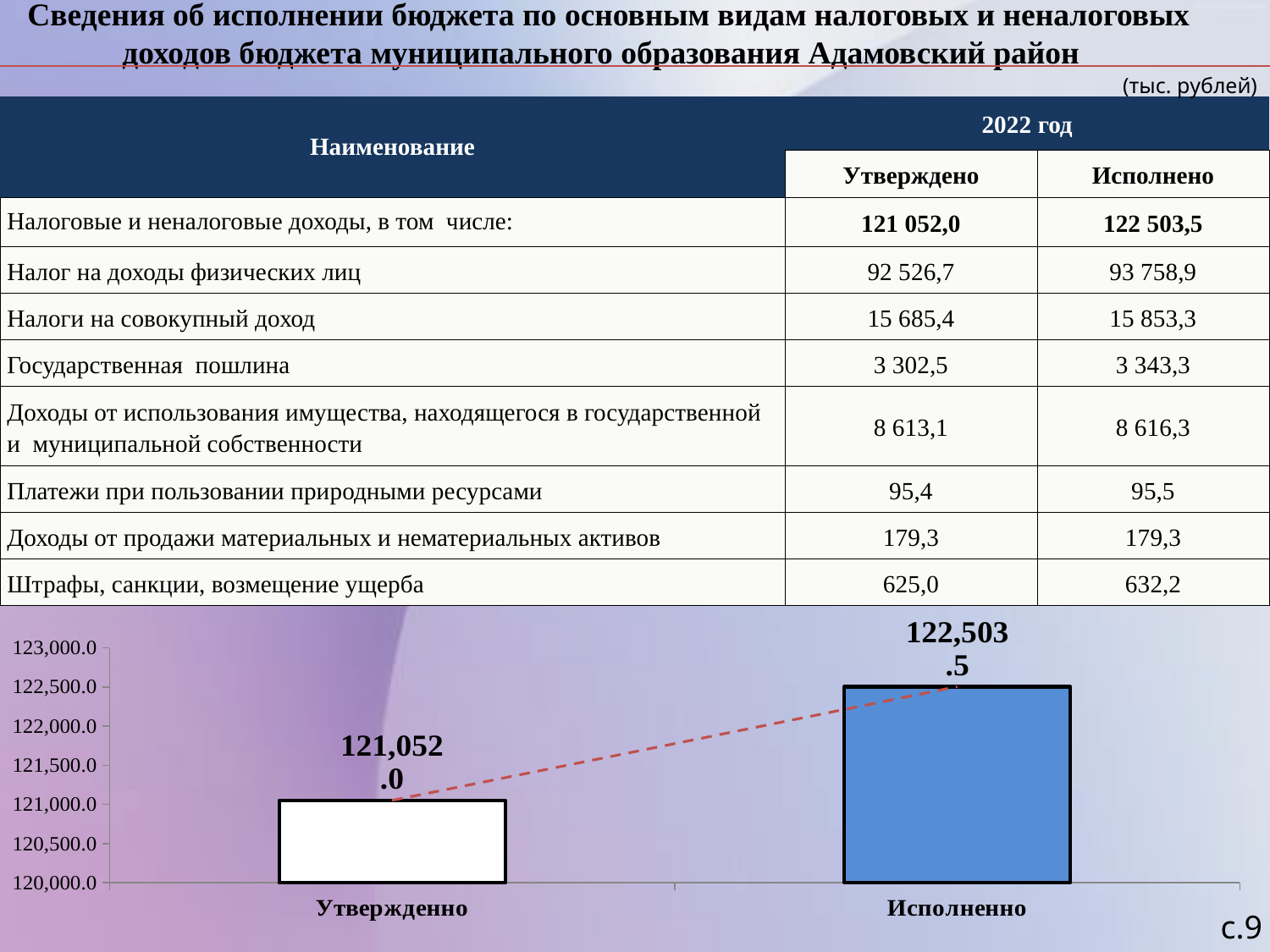
Do the values in the chart rise or fall from Утвержденно to Исполненно? rise Which is larger in the chart, Утвержденно or Исполненно? Исполненно What is the value of the Утвержденно bar in the chart? 121,052.0 What is the value of the Исполненно bar in the chart? 122,503.5 Which bar in the chart is the lowest? Утвержденно What is the difference between the Исполненно and Утвержденно values in the chart? 1,451.5 What kind of chart is shown at the bottom of the slide? bar chart Is the value for Утвержденно in the chart greater or less than 121,500.0? less Which bar in the chart is the highest? Исполненно Is the value for Исполненно in the chart greater or less than 122,000.0? greater How many bars are shown in the chart? 2 What is the highest value shown on the chart's vertical axis? 123,000.0